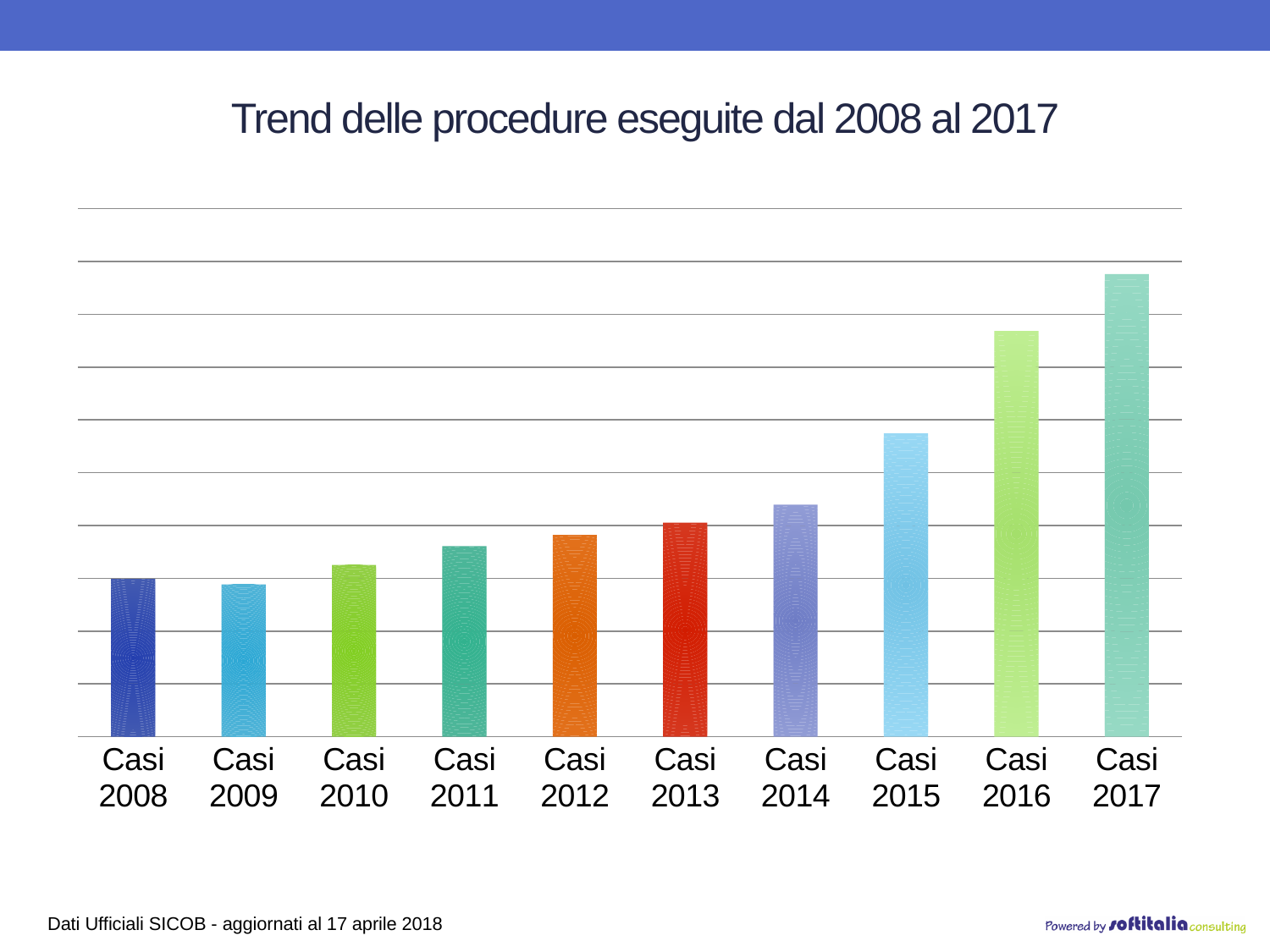
Which category has the highest bar in the chart? Casi 2017 Which is larger, the value for Casi 2011 or the value for Casi 2014? Casi 2014 Do the values generally rise or fall from Casi 2008 to Casi 2017? Rise Which is larger, the value for Casi 2010 or the value for Casi 2013? Casi 2013 Which is larger, the value for Casi 2015 or the value for Casi 2016? Casi 2016 How many bars (categories) are shown in the chart? 10 What is the title of the chart? Trend delle procedure eseguite dal 2008 al 2017 What is the label of the first category on the x axis? Casi 2008 What kind of chart is shown on the slide? Bar chart